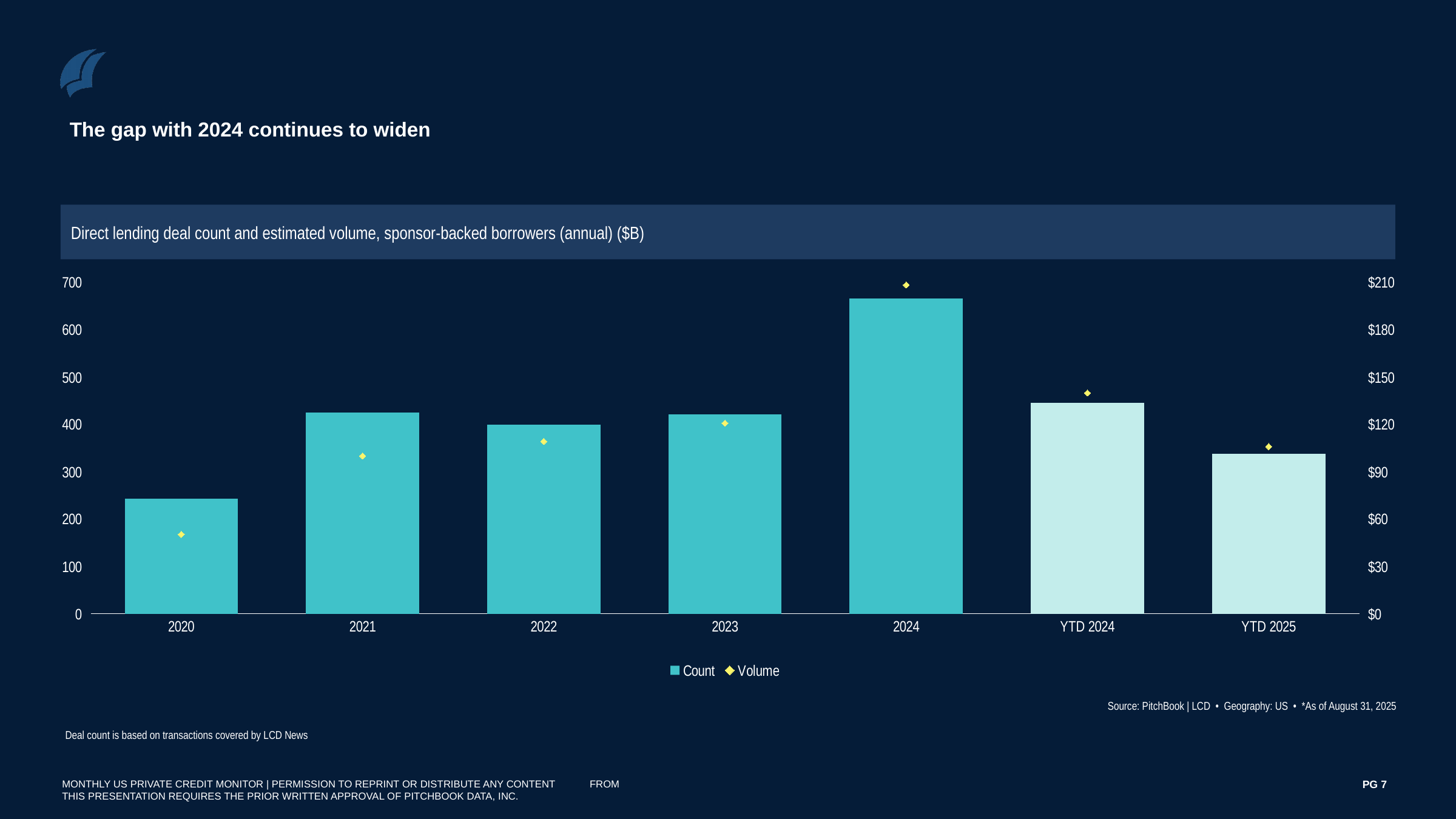
How many categories are shown on the x axis? 7 Which category has the highest volume? 2024 Which category has the lowest deal count? 2020 Is the deal count for 2024 greater or less than 600? greater Which category has the highest deal count? 2024 Which category has the lowest volume? 2020 Which has the larger deal count, YTD 2024 or YTD 2025? YTD 2024 Is the volume for 2024 greater or less than $180? greater Does the volume rise or fall from 2020 to 2024? rise How many series does the legend list? 2 Is the deal count for 2020 greater or less than 300? less What kind of chart is shown on the slide? bar chart